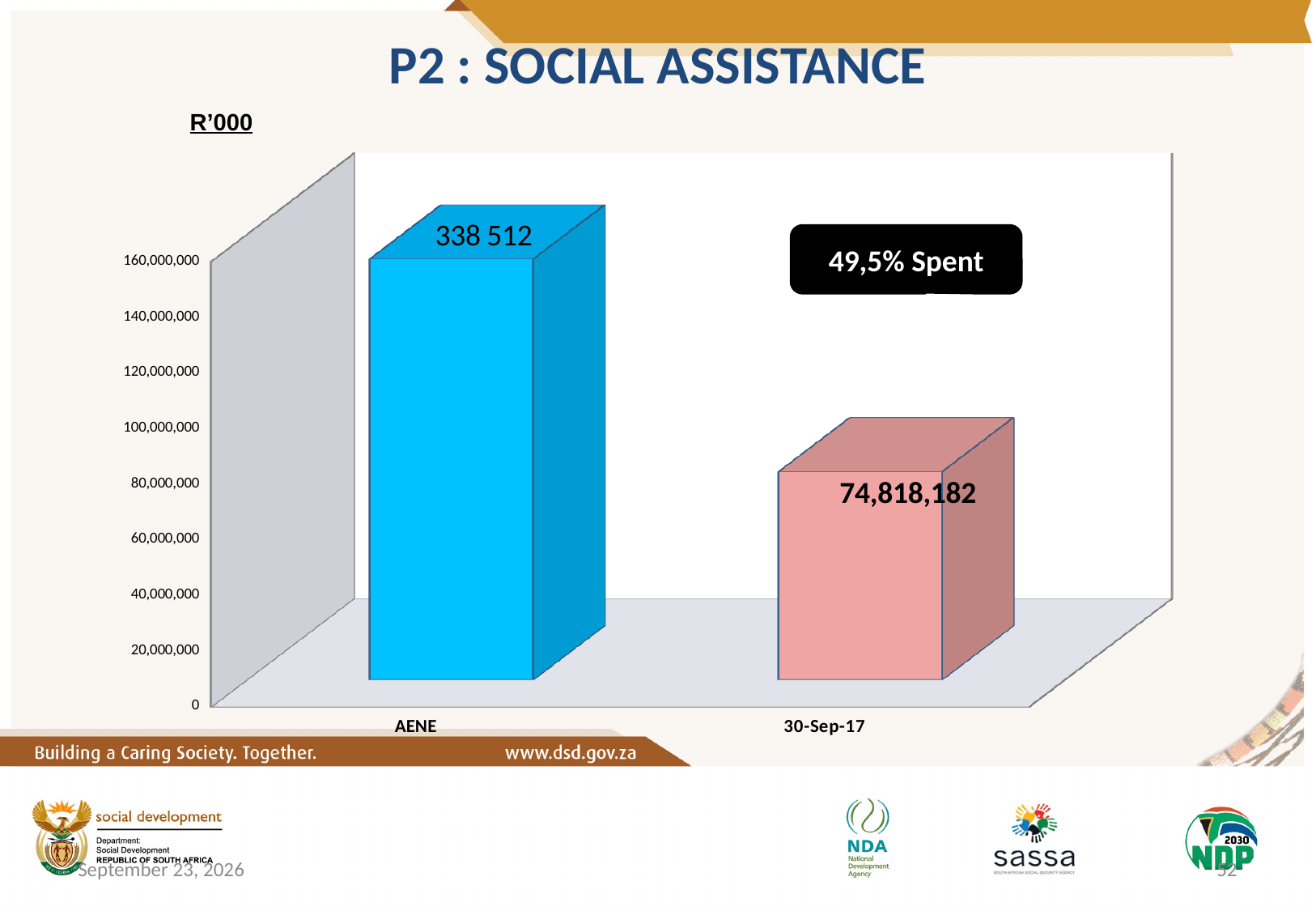
Is the AENE bar taller or shorter than the 30-Sep-17 bar? taller Is the value for AENE greater or less than 140,000,000? greater How many categories are plotted on the chart? 2 What type of chart is shown on the slide? bar chart What percentage spent is shown in the black box on the chart? 49,5% Spent Which category has the taller bar? AENE Which category has the shorter bar? 30-Sep-17 What is the value labelled on the 30-Sep-17 bar? 74,818,182 What is the value labelled on the AENE bar? 338 512 Is the value for 30-Sep-17 greater or less than 100,000,000? less What is the title of the slide containing the chart? P2 : SOCIAL ASSISTANCE